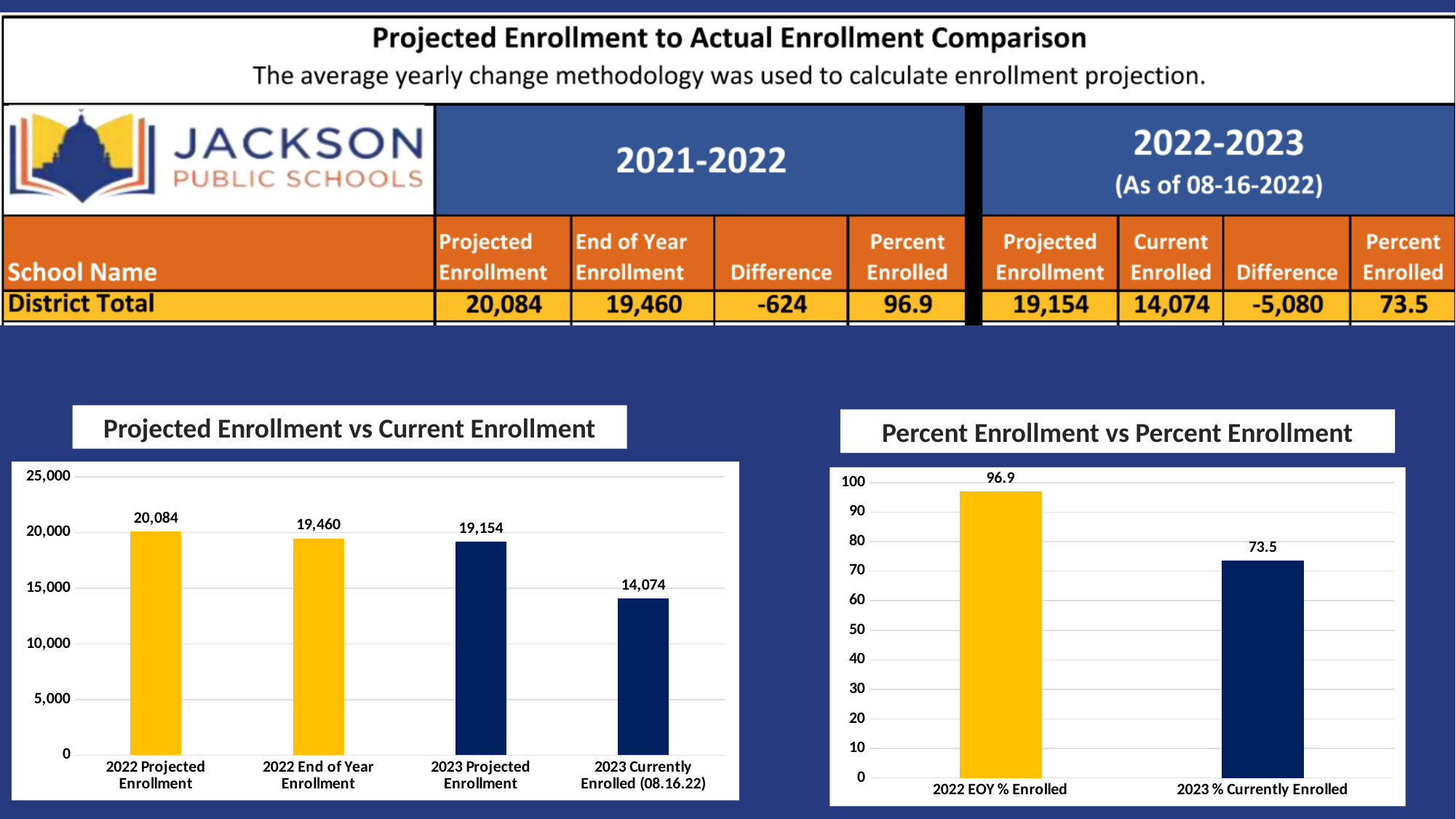
In the 'Projected Enrollment vs Current Enrollment' chart, what is the value for 2023 Currently Enrolled (08.16.22)? 14,074 In the 'Projected Enrollment vs Current Enrollment' chart, what is the difference between 2023 Projected Enrollment and 2023 Currently Enrolled (08.16.22)? 5,080 In the 'Projected Enrollment vs Current Enrollment' chart, how many bars are plotted? 4 In the 'Projected Enrollment vs Current Enrollment' chart, which category has the lowest value? 2023 Currently Enrolled (08.16.22) In the 'Projected Enrollment vs Current Enrollment' chart, is the value for 2023 Currently Enrolled (08.16.22) greater or less than 15,000? less In the 'Percent Enrollment vs Percent Enrollment' chart, what is the value for 2022 EOY % Enrolled? 96.9 In the 'Projected Enrollment vs Current Enrollment' chart, which category has the highest value? 2022 Projected Enrollment In the 'Percent Enrollment vs Percent Enrollment' chart, what is the value for 2023 % Currently Enrolled? 73.5 In the 'Percent Enrollment vs Percent Enrollment' chart, which is larger: 2022 EOY % Enrolled or 2023 % Currently Enrolled? 2022 EOY % Enrolled In the 'Projected Enrollment vs Current Enrollment' chart, what is the value for 2022 Projected Enrollment? 20,084 What type of chart is the 'Percent Enrollment vs Percent Enrollment' chart? Bar chart In the 'Percent Enrollment vs Percent Enrollment' chart, what is the difference between 2022 EOY % Enrolled and 2023 % Currently Enrolled? 23.4